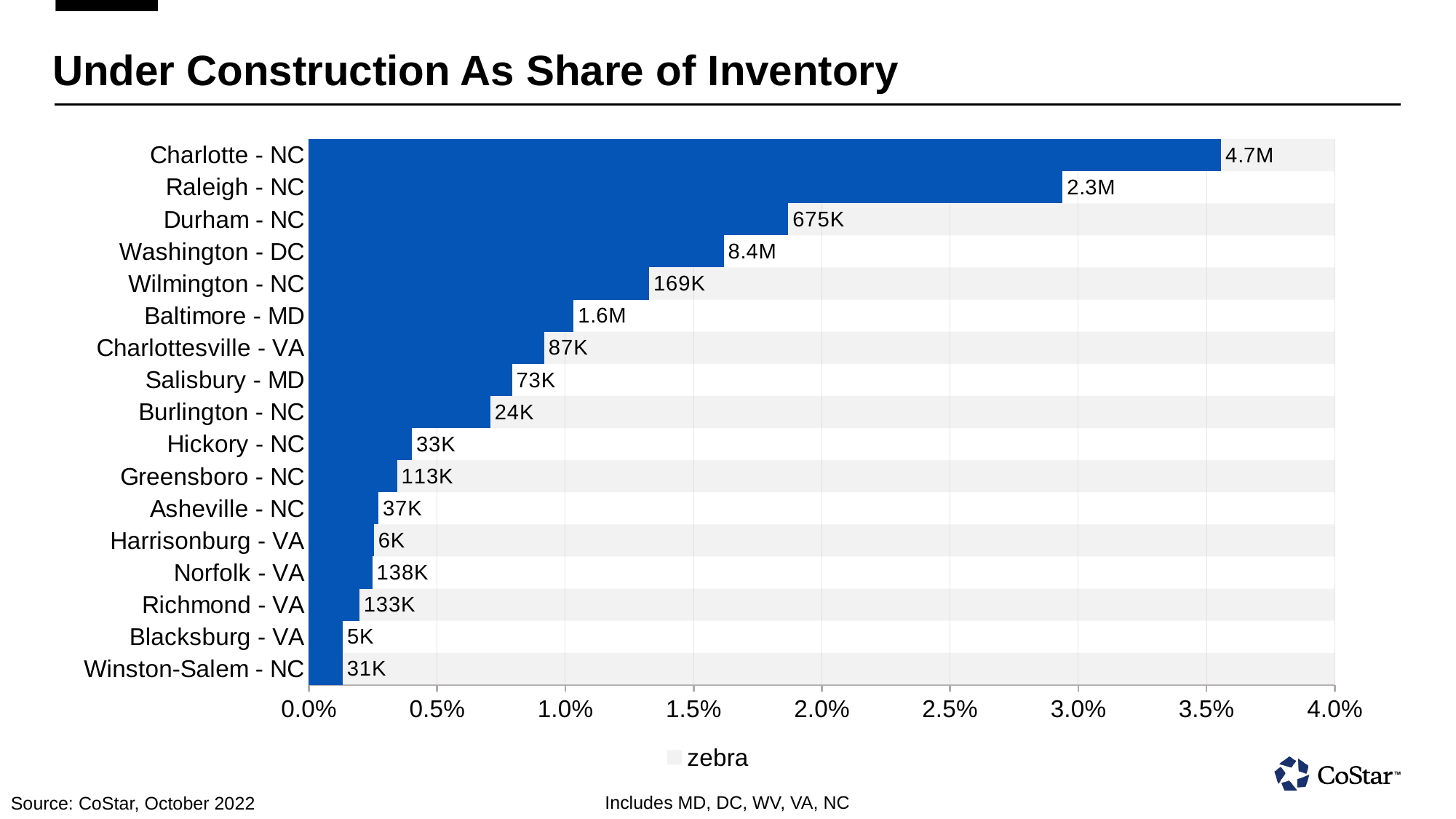
What is the title of the chart? Under Construction As Share of Inventory What type of chart is shown on the slide? bar chart Which market has the highest under construction share of inventory? Charlotte - NC Is the under construction share for Wilmington - NC greater or less than 1.5%? less What label is printed on the bar for Charlotte - NC? 4.7M Which has a larger under construction share, Durham - NC or Washington - DC? Durham - NC What label is printed on the bar for Greensboro - NC? 113K Is the under construction share for Charlotte - NC greater or less than 3.0%? greater What label is printed on the bar for Washington - DC? 8.4M Is the under construction share for Charlottesville - VA greater or less than 1.0%? less Do the bars get longer or shorter moving from the top of the chart to the bottom? shorter How many markets are listed on the chart? 17